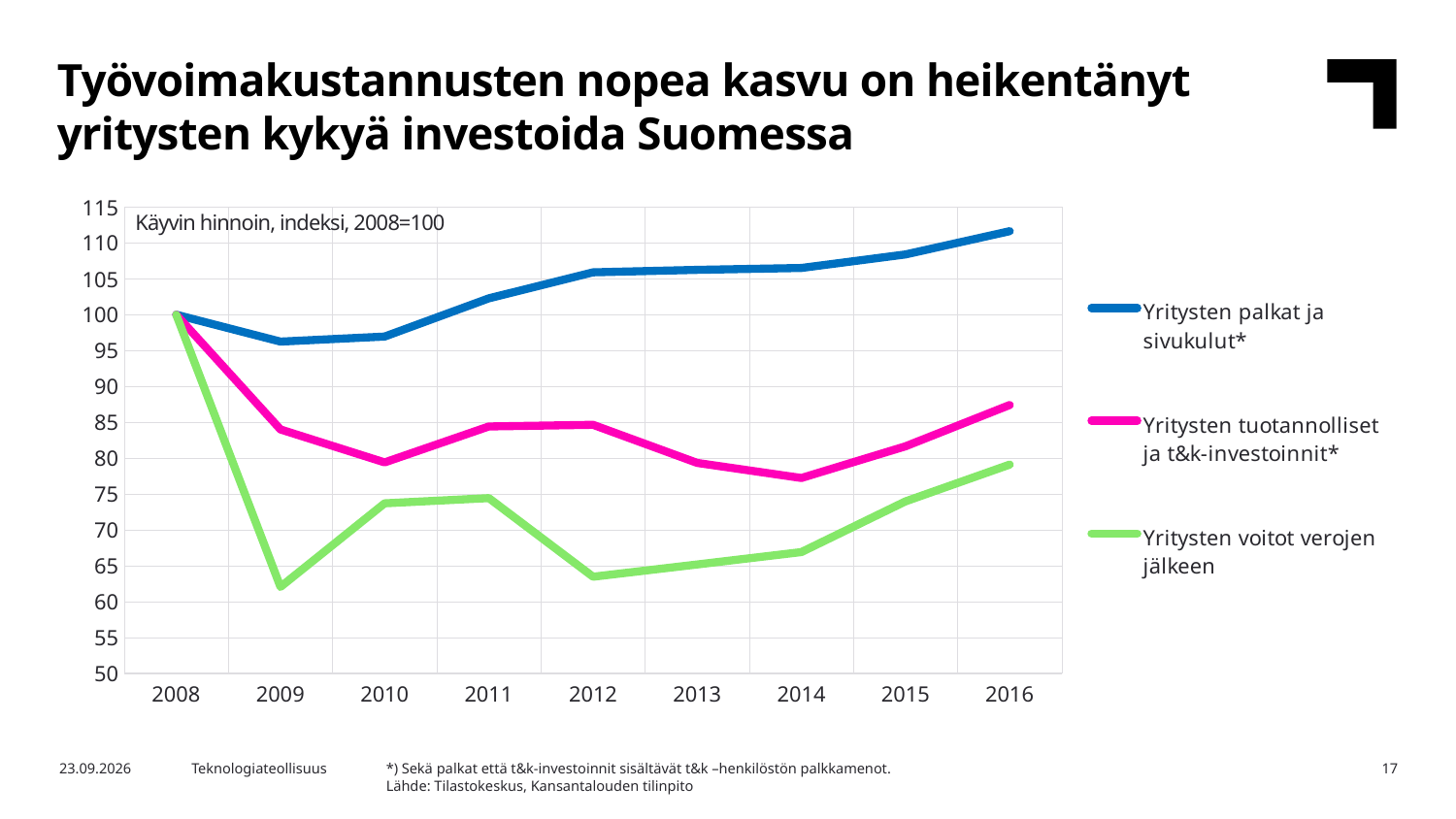
What is the value of Yritysten palkat ja sivukulut in 2008? 100 Is the value for Yritysten voitot verojen jälkeen in 2016 greater or less than 75? greater Is the value for Yritysten voitot verojen jälkeen in 2009 greater or less than 65? less In 2012, is Yritysten tuotannolliset ja t&k-investoinnit higher or lower than Yritysten voitot verojen jälkeen? higher Does Yritysten palkat ja sivukulut rise or fall from 2010 to 2016? rise Is the value for Yritysten palkat ja sivukulut in 2016 greater or less than 110? greater Which series has the highest value in 2016? Yritysten palkat ja sivukulut How many series does the legend list? 3 How many years are plotted along the x axis? 9 Which series has the lowest value in 2009? Yritysten voitot verojen jälkeen What type of chart is shown on the slide? line chart